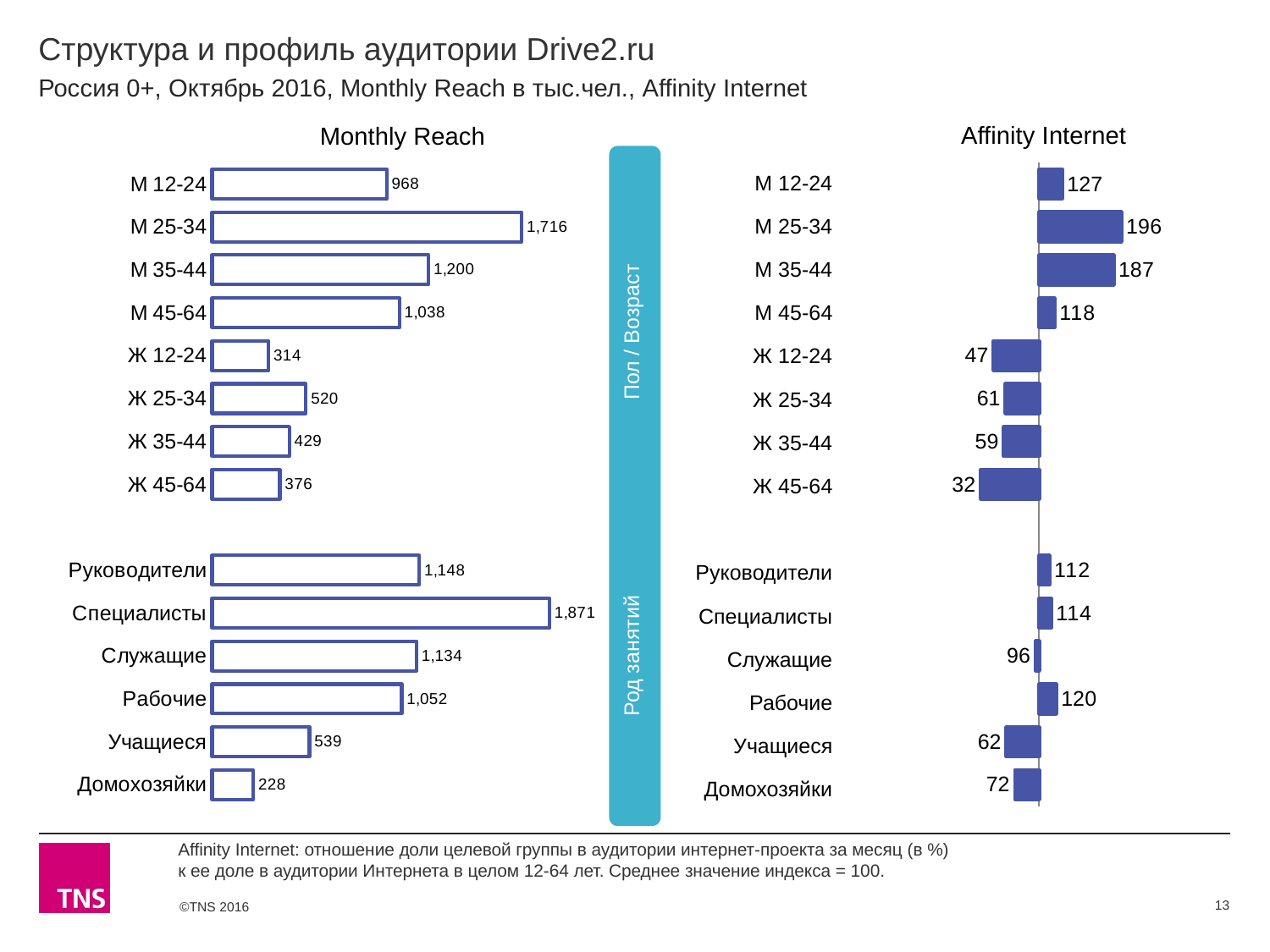
In the Monthly Reach chart, what is the value for М 25-34? 1,716 In the Monthly Reach chart, what is the difference between М 35-44 and Ж 35-44? 771 In the Monthly Reach chart, which category has the lowest value? Домохозяйки In the Monthly Reach chart, what is the value for Домохозяйки? 228 In the Monthly Reach chart, which category has the highest value? Специалисты In the Affinity Internet chart, what is the value for Рабочие? 120 In the Affinity Internet chart, what is the difference between М 25-34 and М 35-44? 9 In the Affinity Internet chart, which is larger, the value for Руководители or the value for Специалисты? Специалисты What type of chart is the Affinity Internet chart? Bar chart In the Affinity Internet chart, what is the value for Ж 45-64? 32 How many categories are shown in the Monthly Reach chart? 14 In the Affinity Internet chart, which category has the highest value? М 25-34